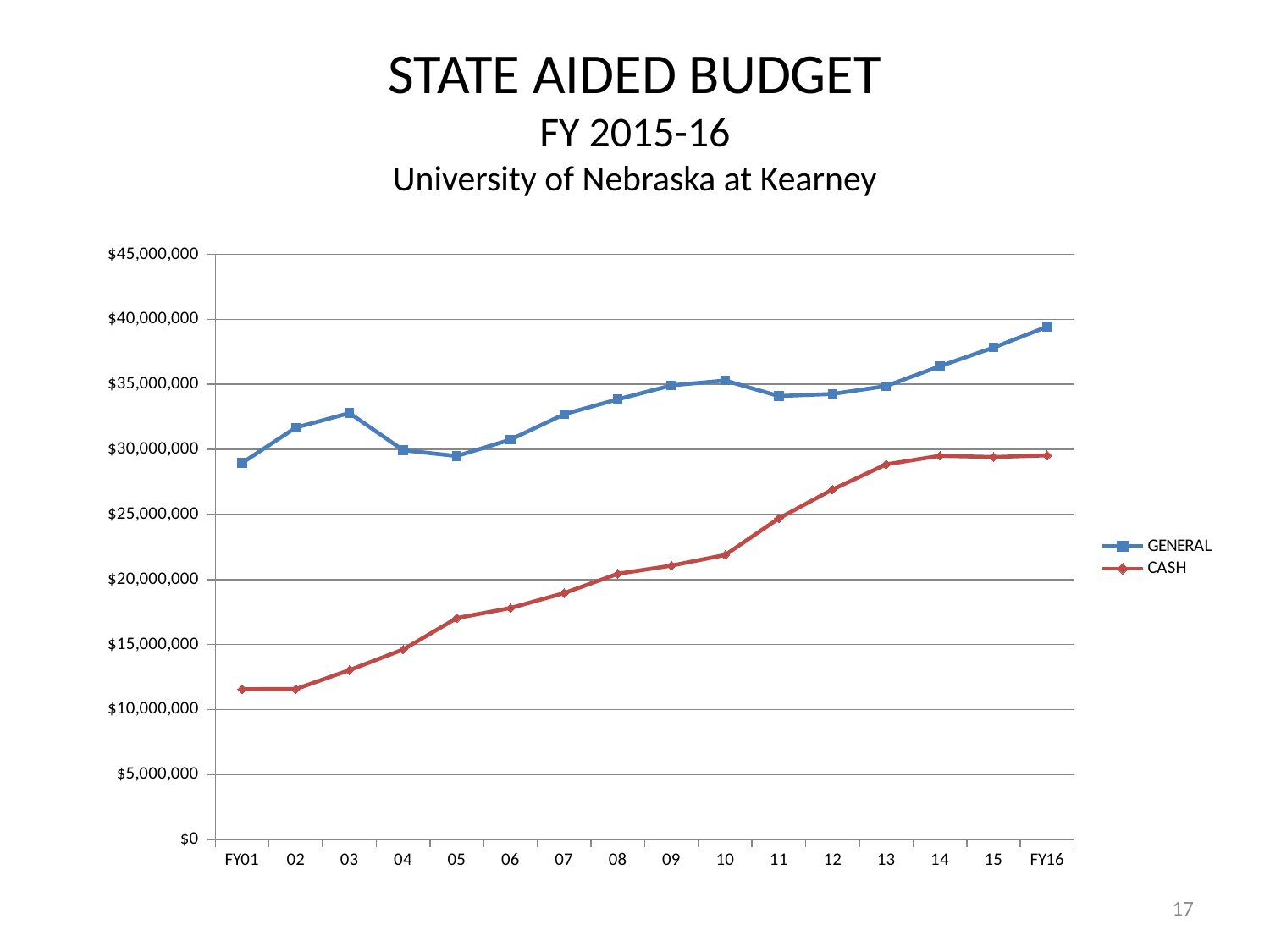
Does the CASH series generally rise or fall from FY01 to FY16? rise Is the GENERAL value for FY16 greater or less than $35,000,000? greater Is the GENERAL value for 03 greater or less than $30,000,000? greater Which series is shown in blue in the legend? GENERAL Which series is shown in red in the legend? CASH How many series does the legend list? 2 What kind of chart is shown on the slide? line chart Is the CASH value for 12 greater or less than $25,000,000? greater In which fiscal year is the GENERAL series at its highest? FY16 In FY01, which series has the larger value, GENERAL or CASH? GENERAL How many fiscal years are plotted along the x axis? 16